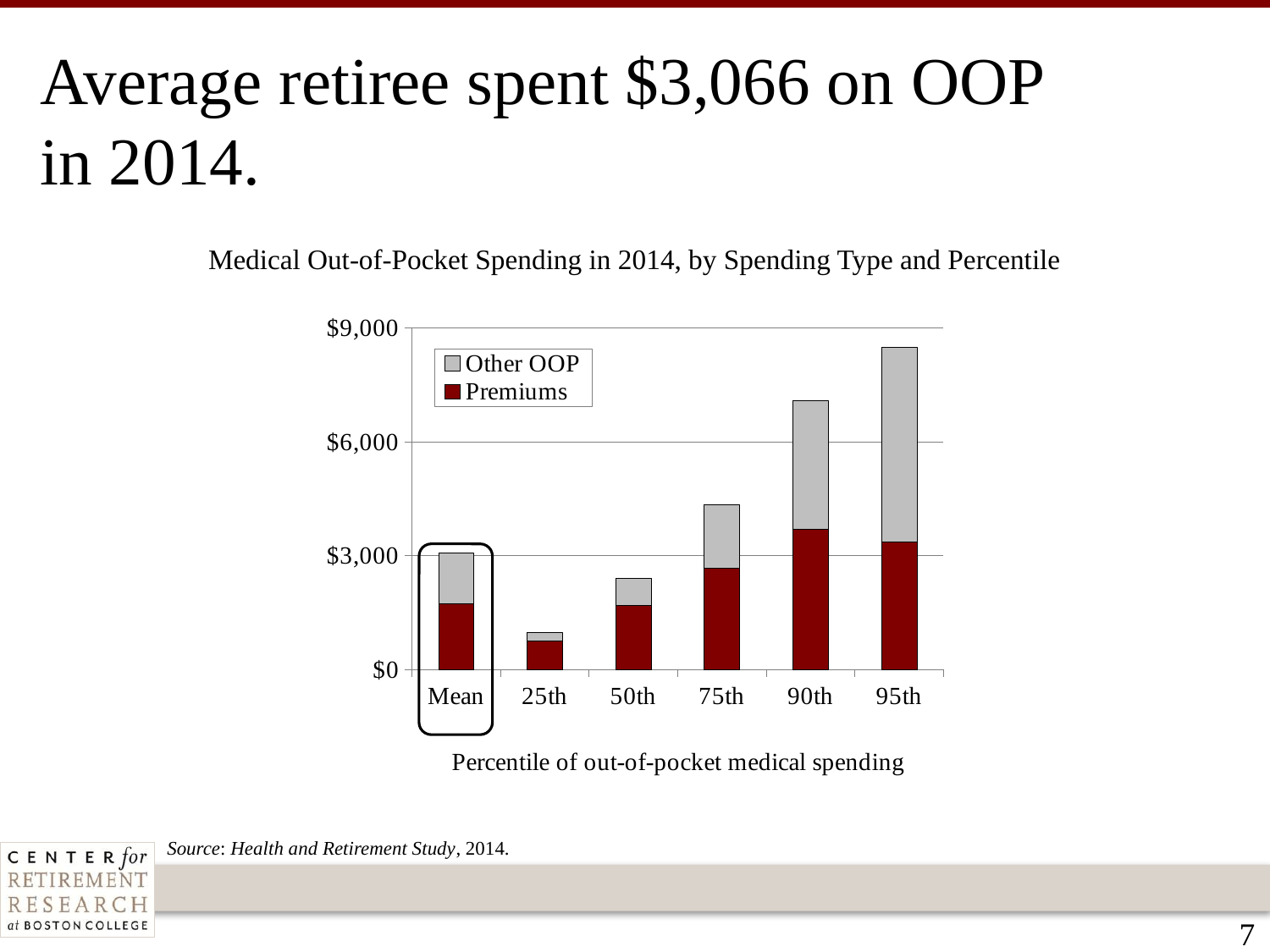
How many series does the legend list? 2 Which has a larger total, the 90th percentile or the 75th percentile? 90th Which category has the lowest total out-of-pocket spending? 25th What kind of chart is shown on the slide? Stacked bar chart How many categories are shown on the x axis? 6 Which category has the highest total out-of-pocket spending? 95th Is the total value for the 95th percentile greater or less than $6,000? greater What is the title of the chart? Medical Out-of-Pocket Spending in 2014, by Spending Type and Percentile Is the total value for the 25th percentile greater or less than $3,000? less Which series is shown in dark red? Premiums Is the Premiums value for the 90th percentile greater or less than $3,000? greater Do total values rise or fall moving from the 25th to the 95th percentile? rise